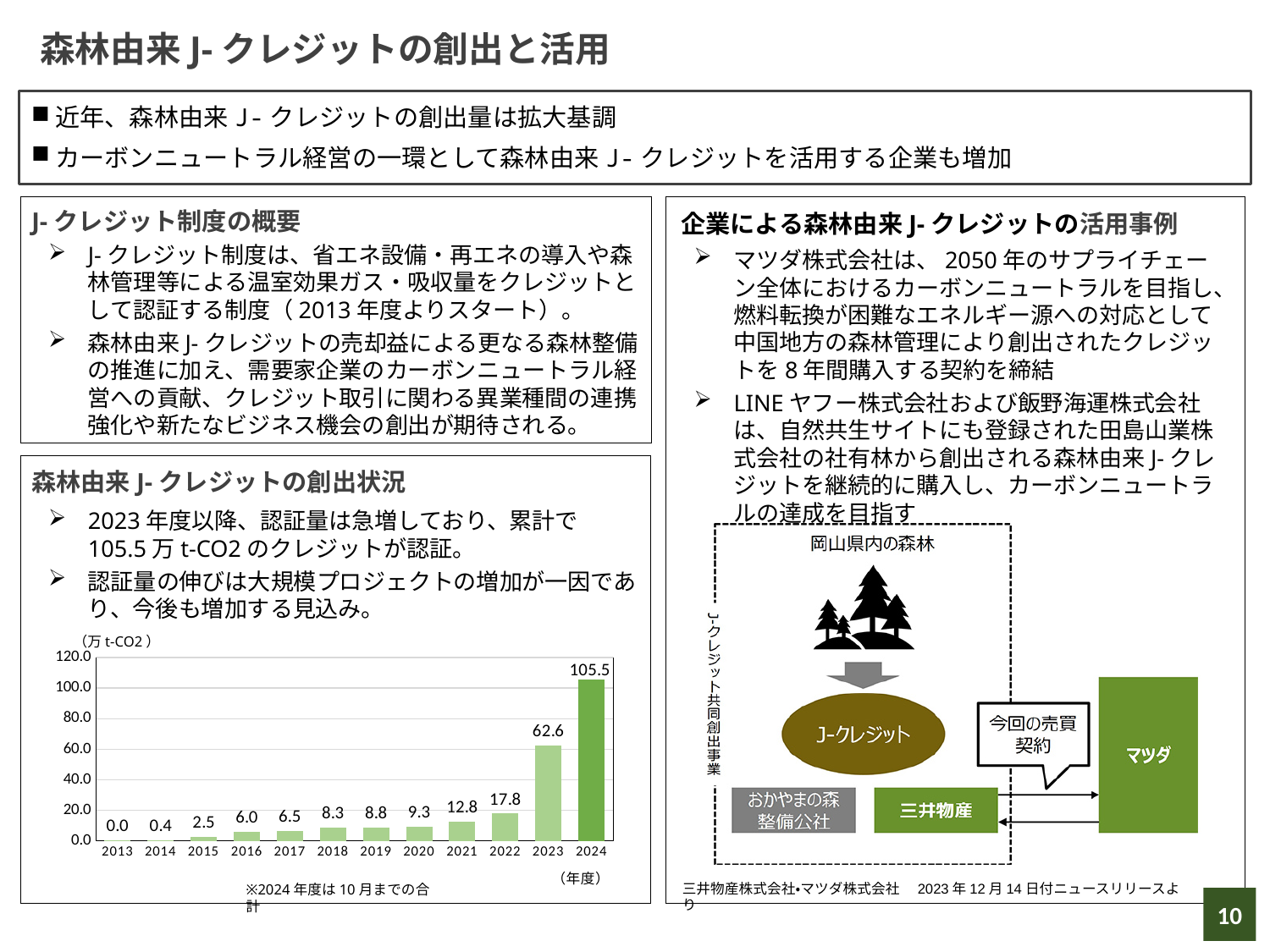
What unit is shown on the y axis of the bar chart? 万 t-CO2 Which is larger in the bar chart, the value for 2022 or the value for 2021? 2022 What is the difference between the values for 2024 and 2023 in the bar chart? 42.9 Which year has the lowest value in the bar chart? 2013 Which year has the highest value in the bar chart? 2024 Is the value for 2023 in the bar chart greater or less than 40.0? greater What is the value for 2021 in the bar chart? 12.8 How many years are shown on the x axis of the bar chart? 12 What is the value for 2024 in the bar chart? 105.5 Do the values in the bar chart rise or fall from 2013 to 2024? rise What kind of chart is shown on the slide? bar chart What is the value for 2023 in the bar chart? 62.6